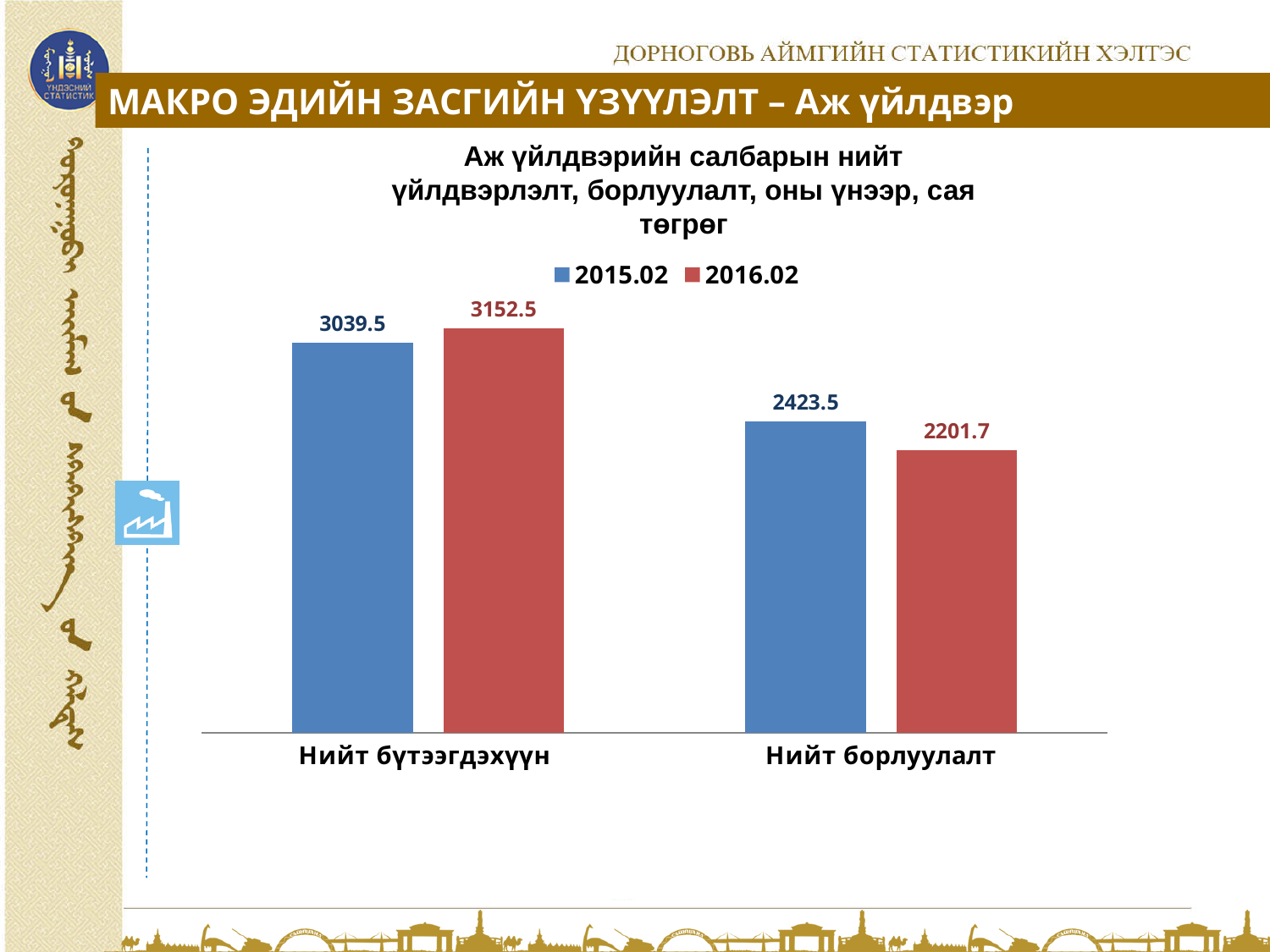
What is the value for Нийт борлуулалт in the 2016.02 series? 2201.7 What is the value for Нийт борлуулалт in the 2015.02 series? 2423.5 For Нийт борлуулалт, which series has the larger value, 2015.02 or 2016.02? 2015.02 How many series does the legend list? 2 What is the value for Нийт бүтээгдэхүүн in the 2016.02 series? 3152.5 Which category has the highest value in the 2016.02 series? Нийт бүтээгдэхүүн What is the difference between the 2016.02 and 2015.02 values for Нийт бүтээгдэхүүн? 113.0 What is the difference between the 2015.02 and 2016.02 values for Нийт борлуулалт? 221.8 What is the value for Нийт бүтээгдэхүүн in the 2015.02 series? 3039.5 How many categories are shown on the x axis? 2 Which category has the lowest value in the 2015.02 series? Нийт борлуулалт What kind of chart is shown on the slide? Bar chart